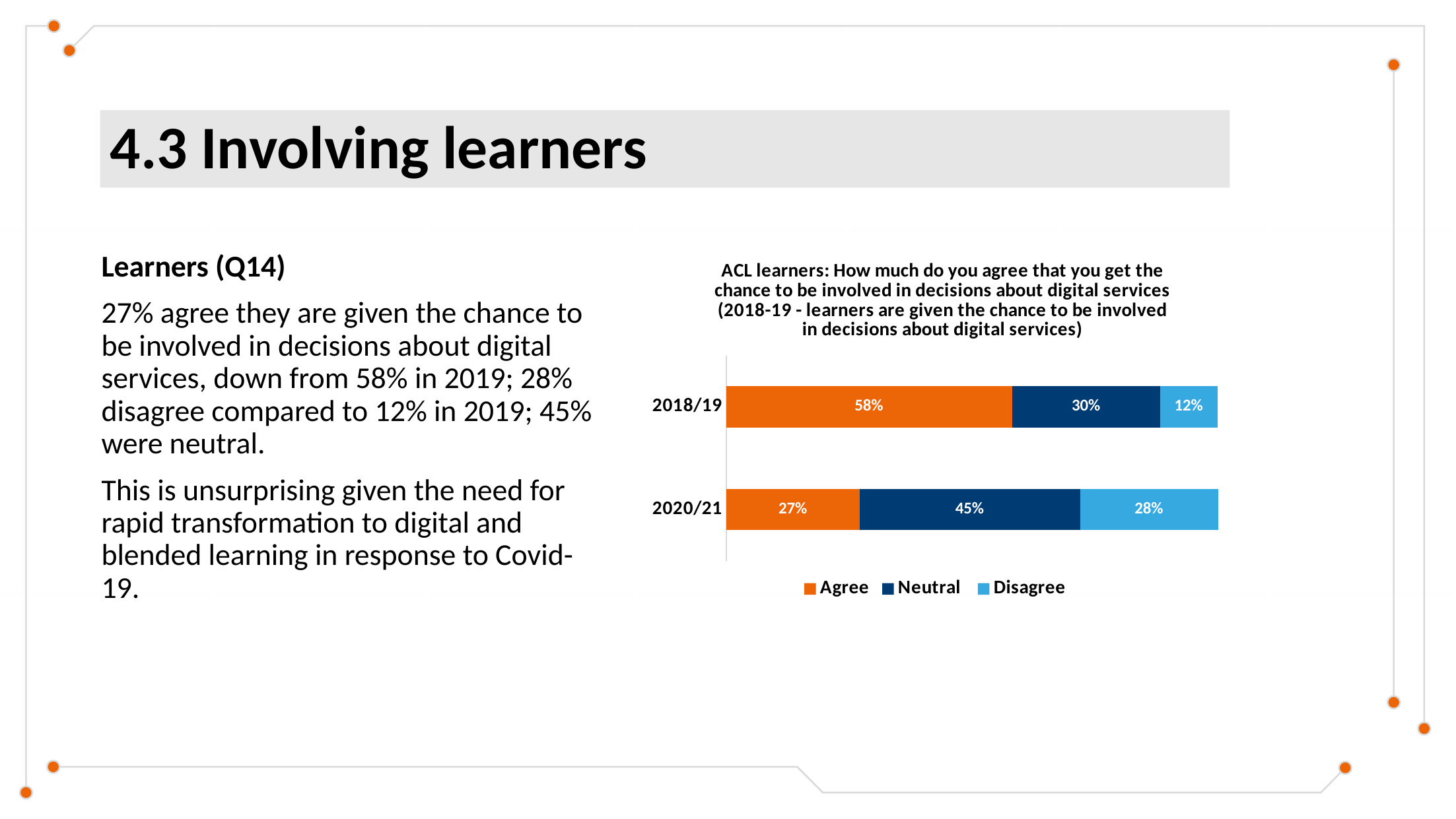
What is the difference in the Neutral percentage between 2020/21 and 2018/19? 15 Which colour represents the Agree series in the chart? Orange What percentage of ACL learners were neutral in 2020/21? 45% How many series does the legend list? 3 How many years are shown on the chart? 2 What kind of chart is shown on the slide? Stacked bar chart By how many percentage points did the Agree share fall from 2018/19 to 2020/21? 31 Which year had the higher Disagree percentage? 2020/21 What percentage of ACL learners disagreed in 2018/19? 12% What percentage of ACL learners agreed in 2018/19? 58% Which year had the higher Agree percentage? 2018/19 What percentage of ACL learners agreed in 2020/21? 27%